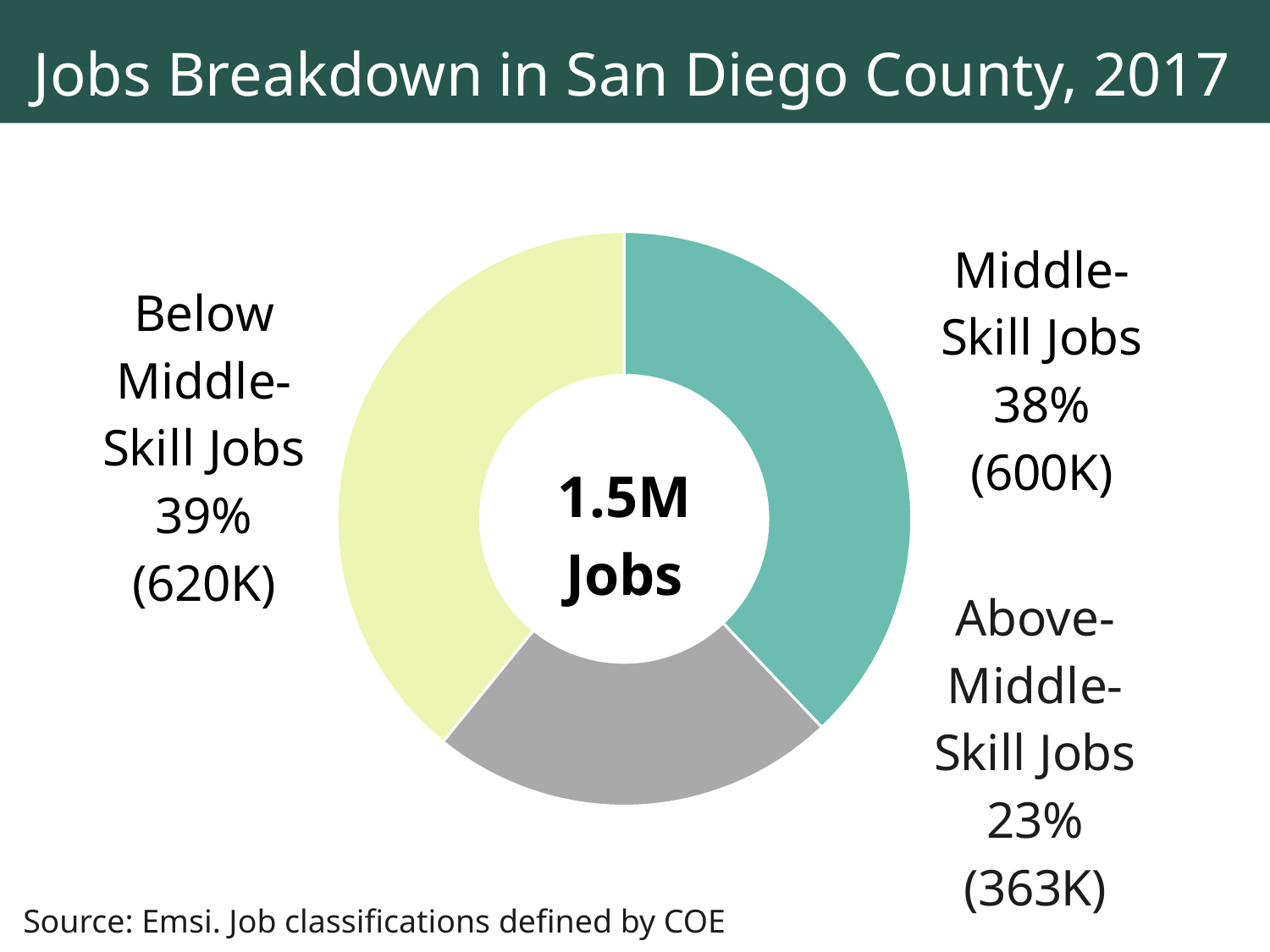
How many job categories does the chart show? 3 What is the difference in percentage points between Below Middle-Skill Jobs and Above-Middle-Skill Jobs? 16% What share of jobs are Below Middle-Skill Jobs? 39% How many jobs are Above-Middle-Skill Jobs? 363K How many jobs are Below Middle-Skill Jobs? 620K What share of jobs are Above-Middle-Skill Jobs? 23% Which is larger, the number of Middle-Skill Jobs or Above-Middle-Skill Jobs? Middle-Skill Jobs What share of jobs are Middle-Skill Jobs? 38% Which job category has the largest share? Below Middle-Skill Jobs What kind of chart is shown on the slide? Doughnut chart Which job category has the smallest share? Above-Middle-Skill Jobs How many jobs are Middle-Skill Jobs? 600K